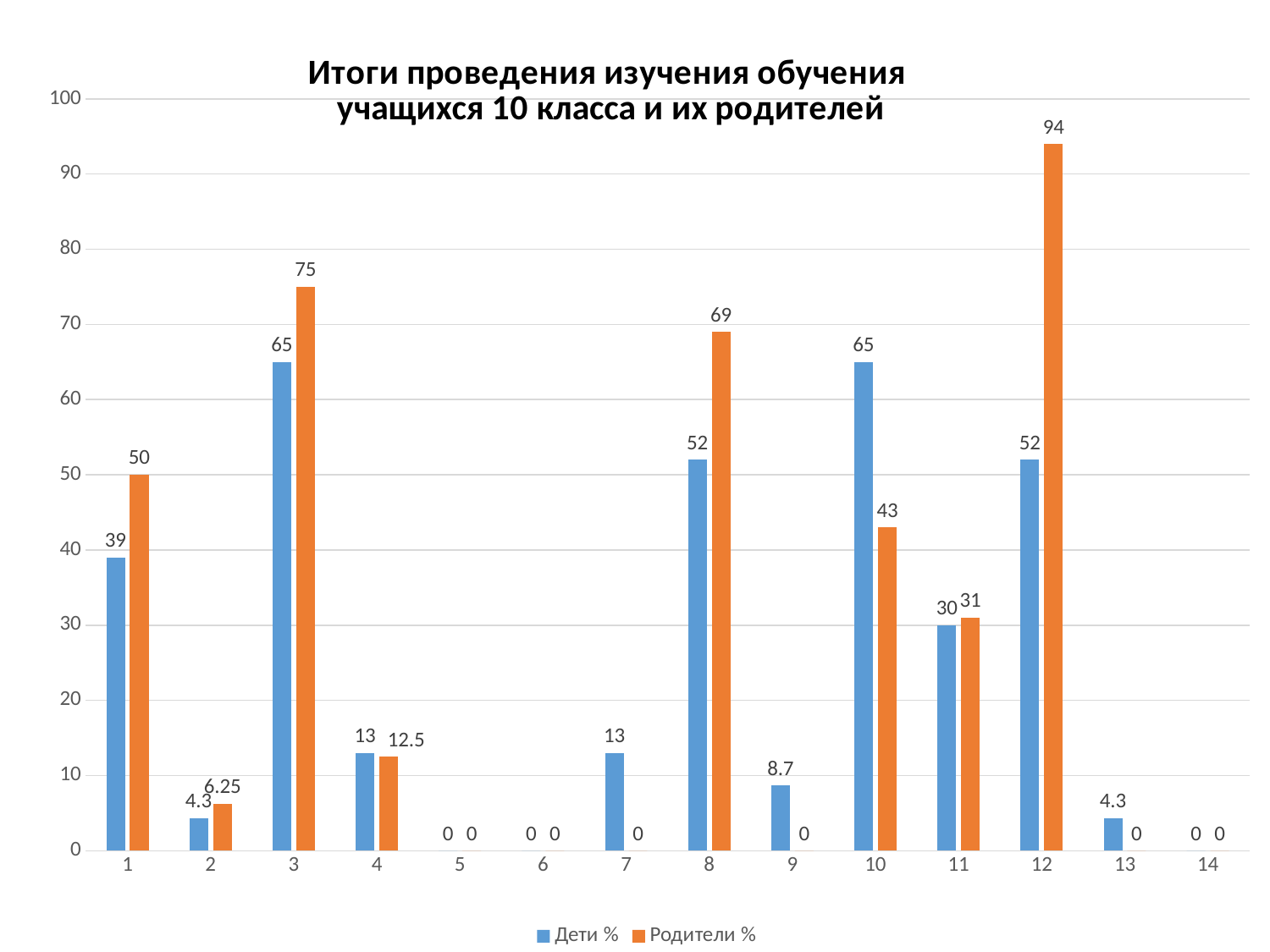
How many series does the legend list? 2 How many categories are shown on the x axis? 14 Which category has the highest value for Дети %? 3 and 10 Is the value for Родители % at category 3 greater or less than 70? greater What is the value for Родители % at category 12? 94 What is the difference between Родители % and Дети % at category 8? 17 Which category has the highest value for Родители %? 12 What is the value for Родители % at category 4? 12.5 At category 10, which series has the larger value, Дети % or Родители %? Дети % What colour are the bars for Родители %? orange What kind of chart is shown on the slide? bar chart What is the value for Дети % at category 1? 39